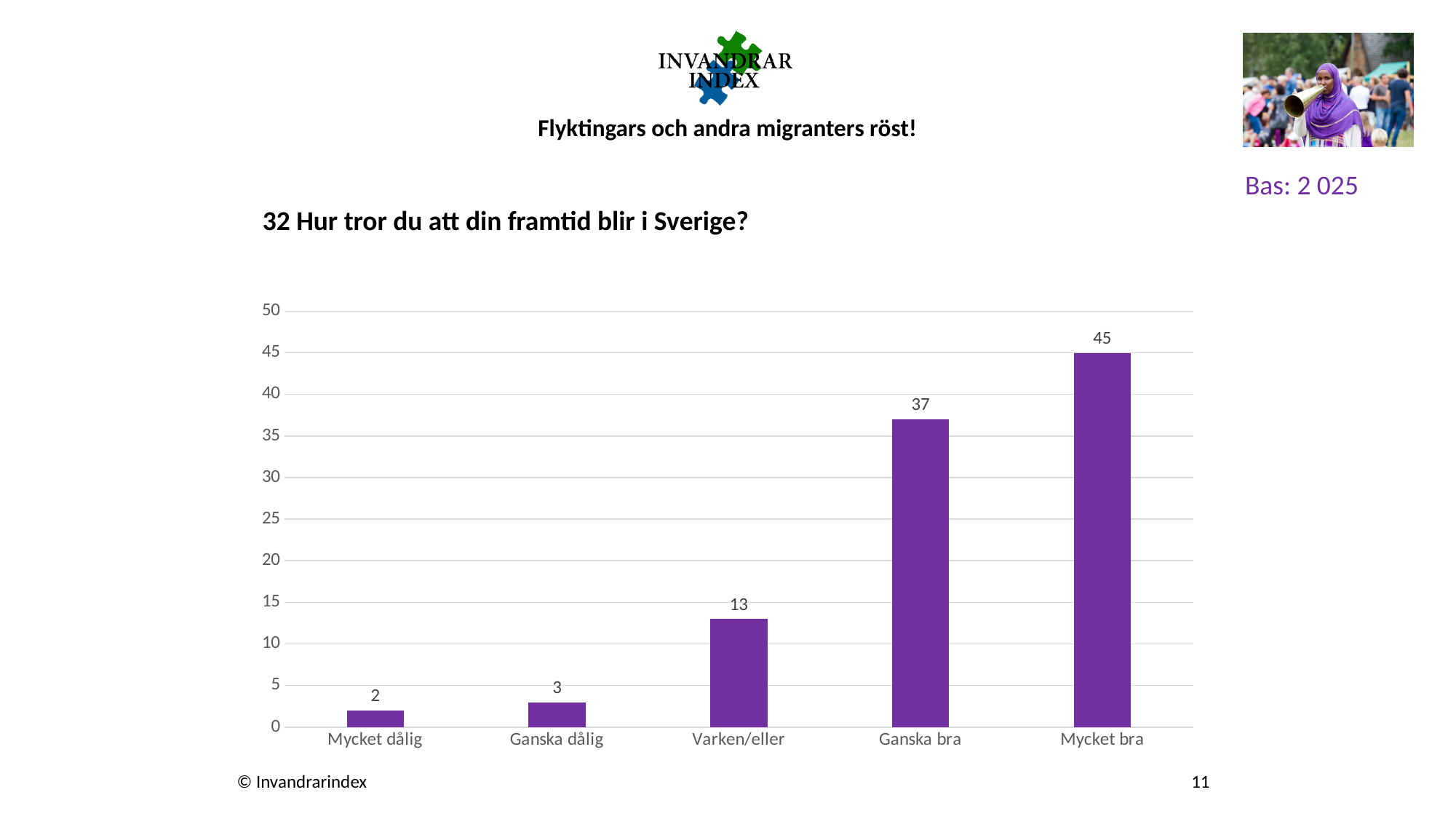
What is the value for Mycket bra? 45 Is the value for Ganska bra greater or less than 30? greater What is the title of the chart? 32 Hur tror du att din framtid blir i Sverige? Which category has the lowest value? Mycket dålig What is the difference between the values for Mycket bra and Ganska bra? 8 Which is larger, the value for Ganska bra or the value for Varken/eller? Ganska bra Do the values rise or fall from left to right along the x axis? rise What is the value for Ganska dålig? 3 How many categories are shown on the x axis? 5 Which category has the highest value? Mycket bra What kind of chart is shown on the slide? bar chart What is the value for Varken/eller? 13